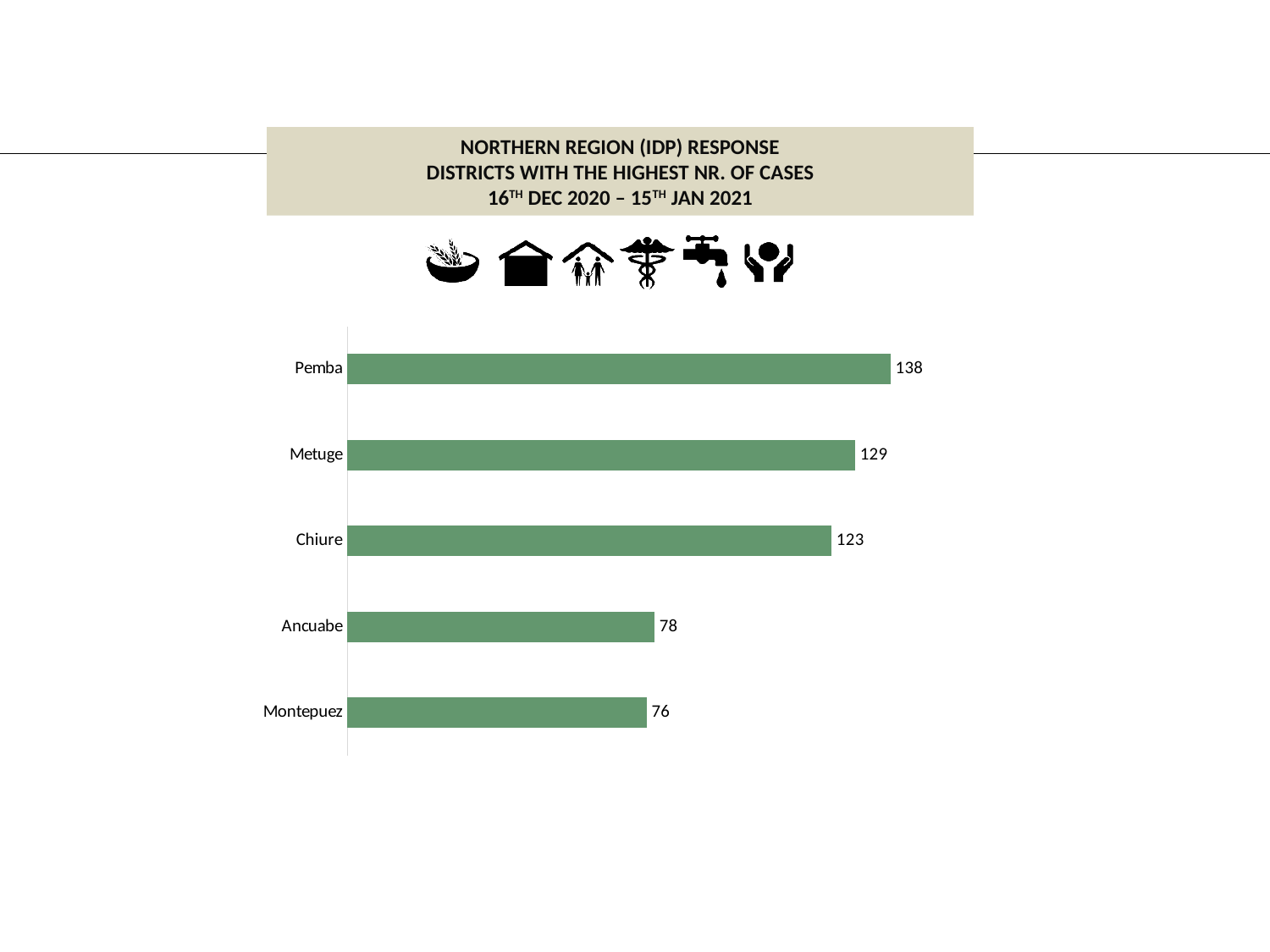
What is the number of cases for Metuge? 129 Which district has the lowest number of cases? Montepuez What is the number of cases for Montepuez? 76 What is the number of cases for Pemba? 138 Which district has the highest number of cases? Pemba Which has more cases, Metuge or Chiure? Metuge What is the difference in cases between Pemba and Metuge? 9 What type of chart is shown on the slide? Bar chart How many districts are shown in the chart? 5 What is the difference in cases between Chiure and Ancuabe? 45 What is the number of cases for Ancuabe? 78 What is the number of cases for Chiure? 123